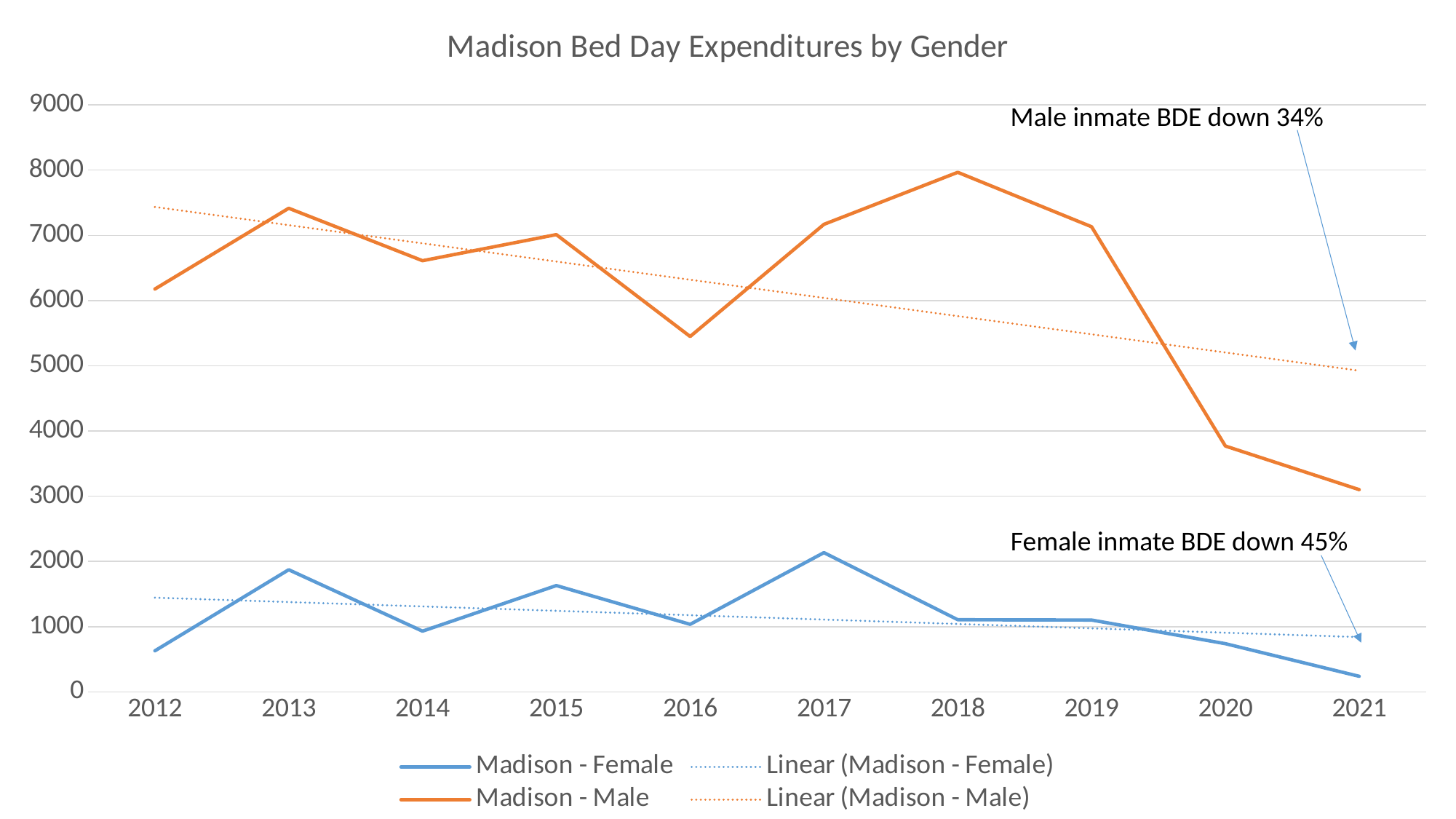
Which series is higher in 2019, Madison - Male or Madison - Female? Madison - Male How many entries does the legend list? 4 Is the Madison - Male value for 2020 greater or less than 3000? greater How many years are shown on the x axis? 10 Is the Madison - Female value for 2017 greater or less than 2000? greater In which year is the Madison - Male series at its lowest? 2021 What kind of chart is shown on the slide? line chart What is the title of the chart? Madison Bed Day Expenditures by Gender In which year is the Madison - Female series at its highest? 2017 In which year is the Madison - Male series at its highest? 2018 Is the Madison - Male value for 2016 greater or less than 6000? less According to the annotation on the chart, by what percentage is female inmate BDE down? 45%